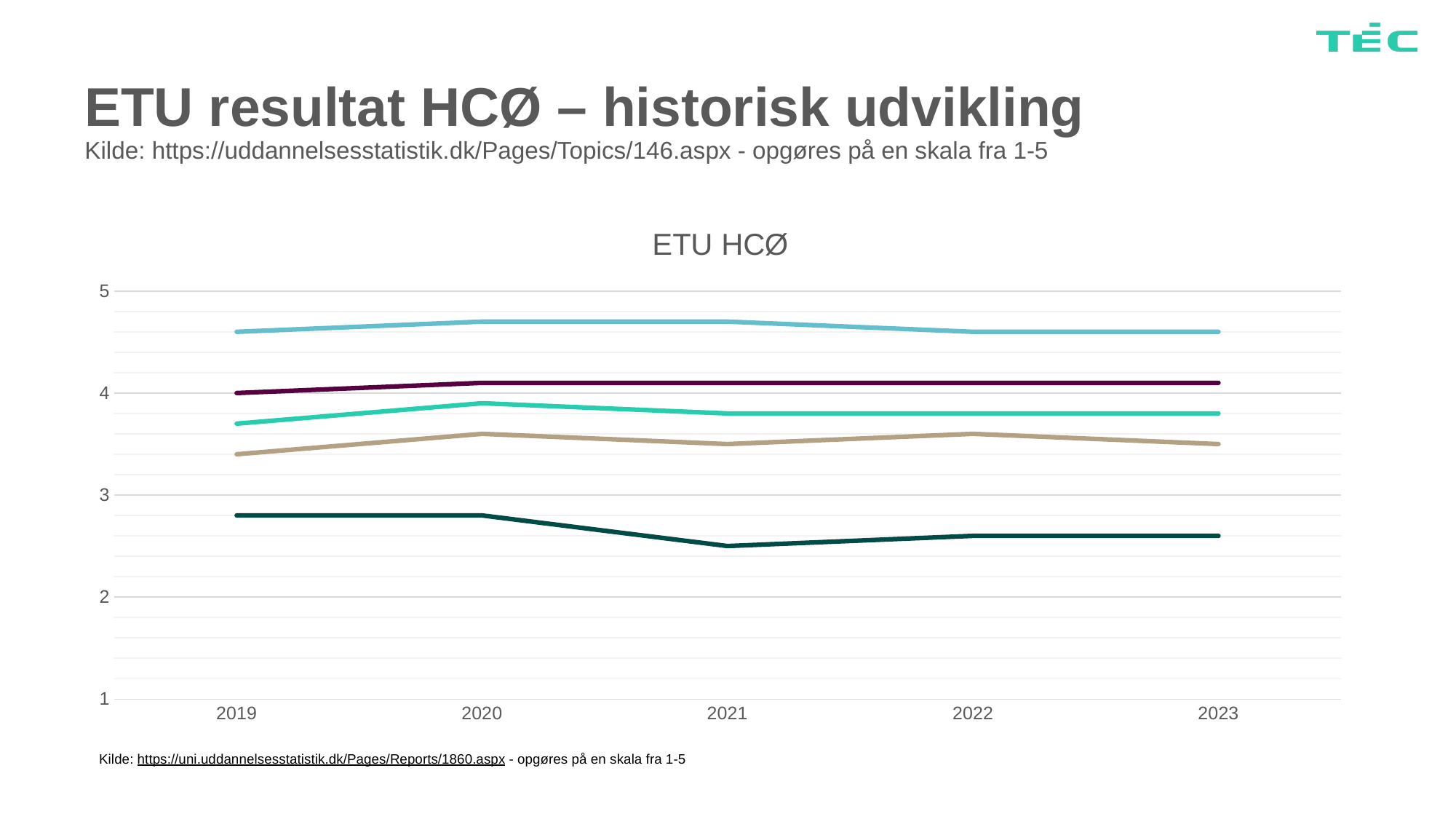
Which line is the highest across all years on the chart? the light blue line Is the value of the tan line in 2019 greater or less than 3? greater In 2023, which is higher: the light blue line or the dark green line? the light blue line What is the first year shown on the x axis? 2019 Is the value of the dark green line in 2021 greater or less than 3? less Which line is the lowest across all years on the chart? the dark green line What kind of chart is shown on the slide? line chart How many years are shown on the x axis of the chart? 5 Is the value of the light blue line in 2021 greater or less than 4? greater Does the dark green line rise or fall from 2020 to 2021? fall How many lines are plotted on the chart? 5 What is the title of the chart? ETU HCØ